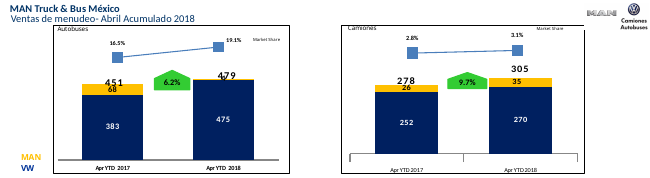
In the Camiones chart, which period has the higher total, Apr YTD 2017 or Apr YTD 2018? Apr YTD 2018 In the Autobuses chart, what is the difference between the Apr YTD 2018 and Apr YTD 2017 totals? 28 In the Camiones chart, what is the MAN value for Apr YTD 2018? 35 In the Camiones chart, what is the market share shown for Apr YTD 2017? 2.8% In the Autobuses chart, what is the total value shown for Apr YTD 2018? 479 What kind of chart is the Camiones chart? Stacked bar chart In the Autobuses chart, what is the total value shown for Apr YTD 2017? 451 In the Camiones chart, what is the VW value for Apr YTD 2017? 252 In the Autobuses chart, what is the MAN value for Apr YTD 2017? 68 In the Camiones chart, what is the total value shown for Apr YTD 2018? 305 In the Autobuses chart, what is the market share shown for Apr YTD 2018? 19.1% In the Autobuses chart, what is the VW value for Apr YTD 2018? 475